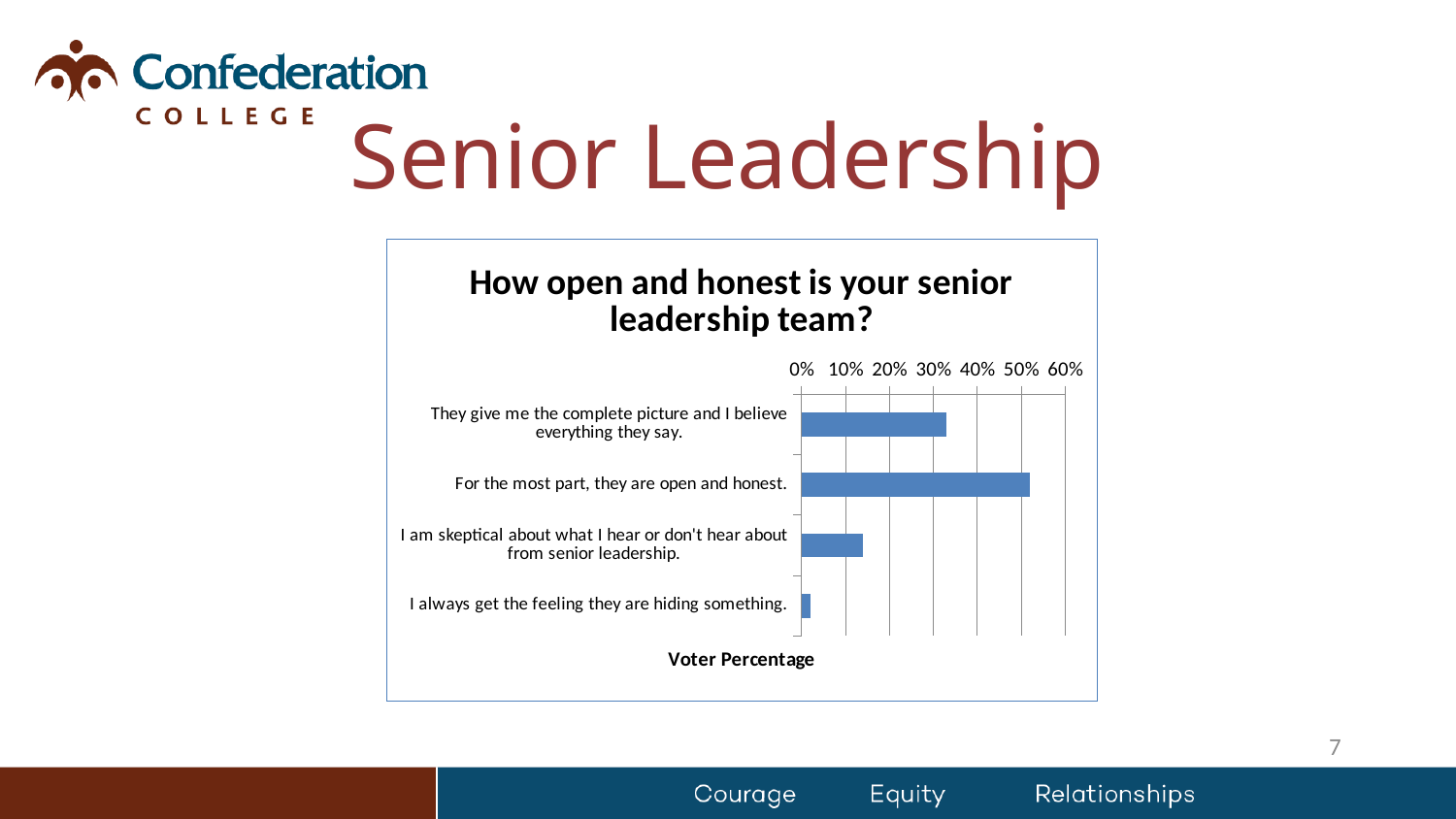
What is the label on the value axis of the chart? Voter Percentage Is the voter percentage for "They give me the complete picture and I believe everything they say." greater or less than 40%? less Which response has the lowest voter percentage? I always get the feeling they are hiding something. Is the voter percentage for "I am skeptical about what I hear or don't hear about from senior leadership." greater or less than 20%? less What kind of chart is shown on the slide? bar chart How many response categories are plotted in the chart? 4 Which response has the highest voter percentage? For the most part, they are open and honest. Is the voter percentage for "I always get the feeling they are hiding something." greater or less than 10%? less What is the title of the chart? How open and honest is your senior leadership team? Which has a larger voter percentage: "They give me the complete picture and I believe everything they say." or "I am skeptical about what I hear or don't hear about from senior leadership."? They give me the complete picture and I believe everything they say.